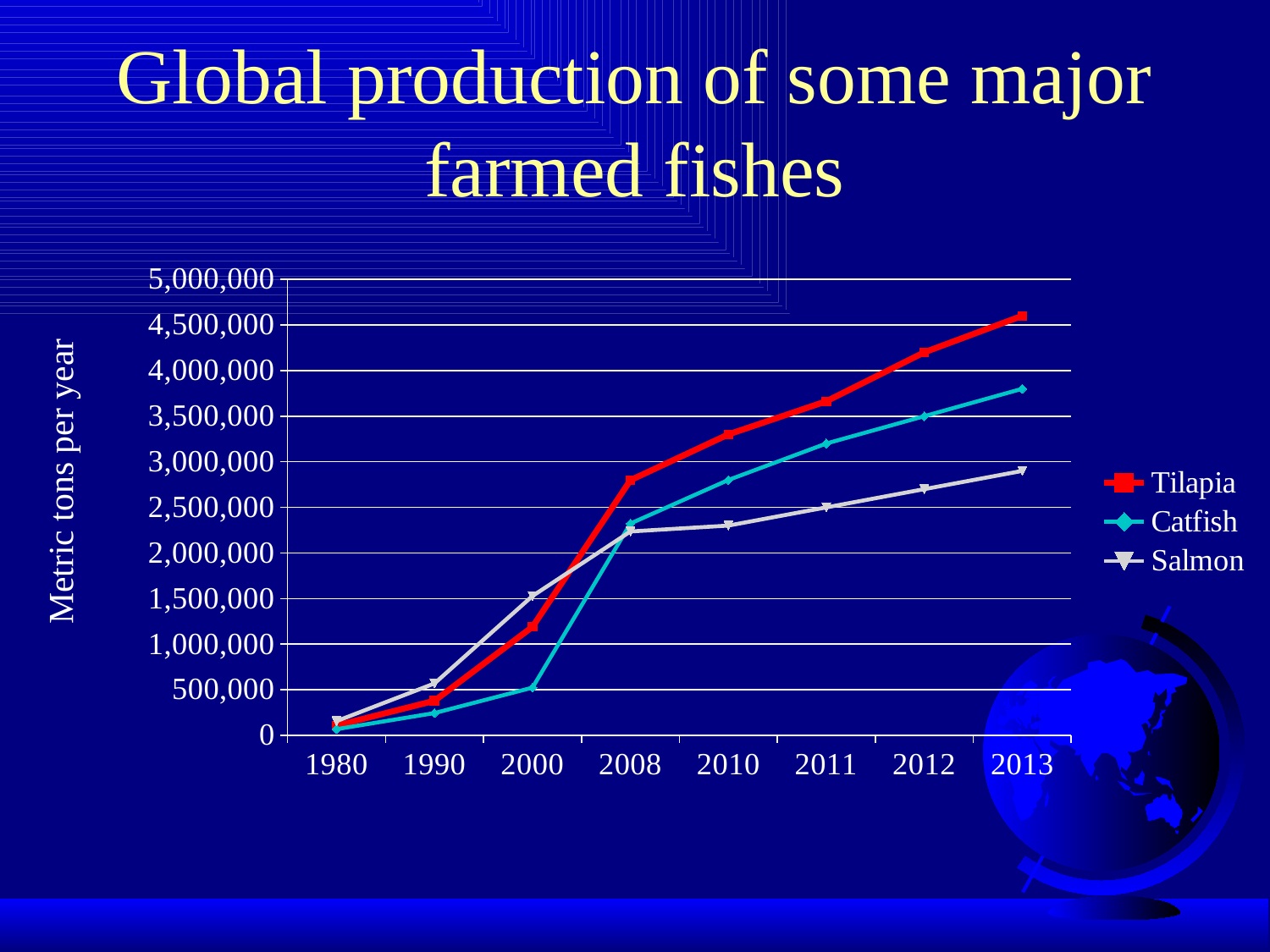
What kind of chart is shown on the slide? line chart Which fish has the highest production in 2013? Tilapia Is the value for Tilapia in 2013 greater or less than 4,500,000? greater What is the label on the y axis? Metric tons per year How many years are shown along the x axis? 8 Does the Tilapia line rise or fall from 1980 to 2013? rise In 2000, which is larger, the production of Salmon or of Tilapia? Salmon How many series does the legend list? 3 Which fish has the lowest production in 2013? Salmon Is the value for Salmon in 2013 greater or less than 3,000,000? less In 2008, which is larger, the production of Tilapia or of Catfish? Tilapia Is the value for Catfish in 2013 greater or less than 4,000,000? less